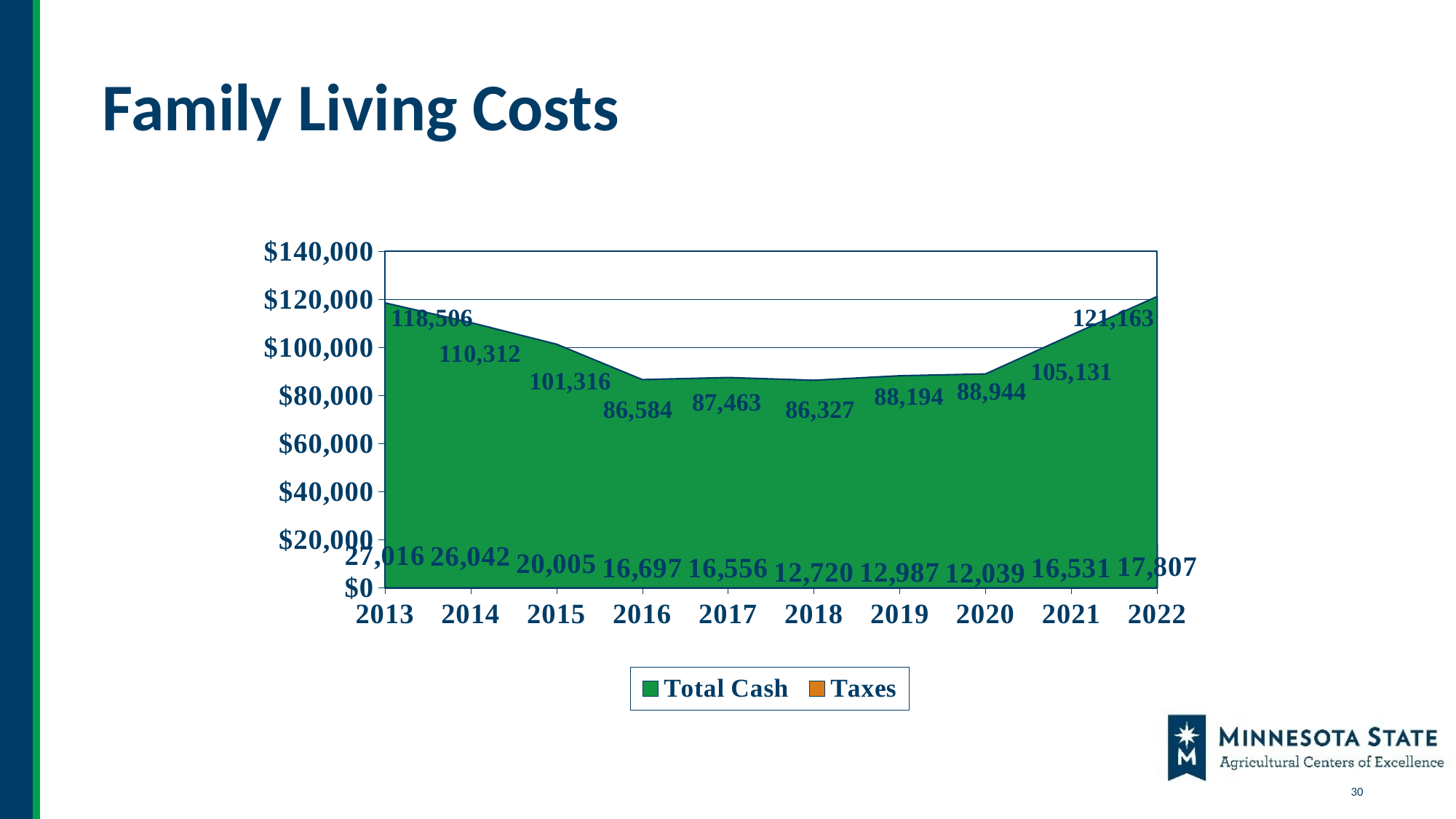
What is the title of the slide? Family Living Costs Which is larger, the Taxes value for 2013 or for 2022? 2013 Is the Total Cash value for 2016 greater or less than $100,000? less What is the Taxes value for 2018? 12,720 What is the Total Cash value for 2013? 118,506 Which year has the lowest Taxes value? 2020 What is the difference between the Total Cash values for 2022 and 2013? 2,657 How many series does the legend list? 2 How many years are shown on the x axis? 10 What is the Total Cash value for 2021? 105,131 Which year has the highest Total Cash value? 2022 What kind of chart is shown on the slide? area chart